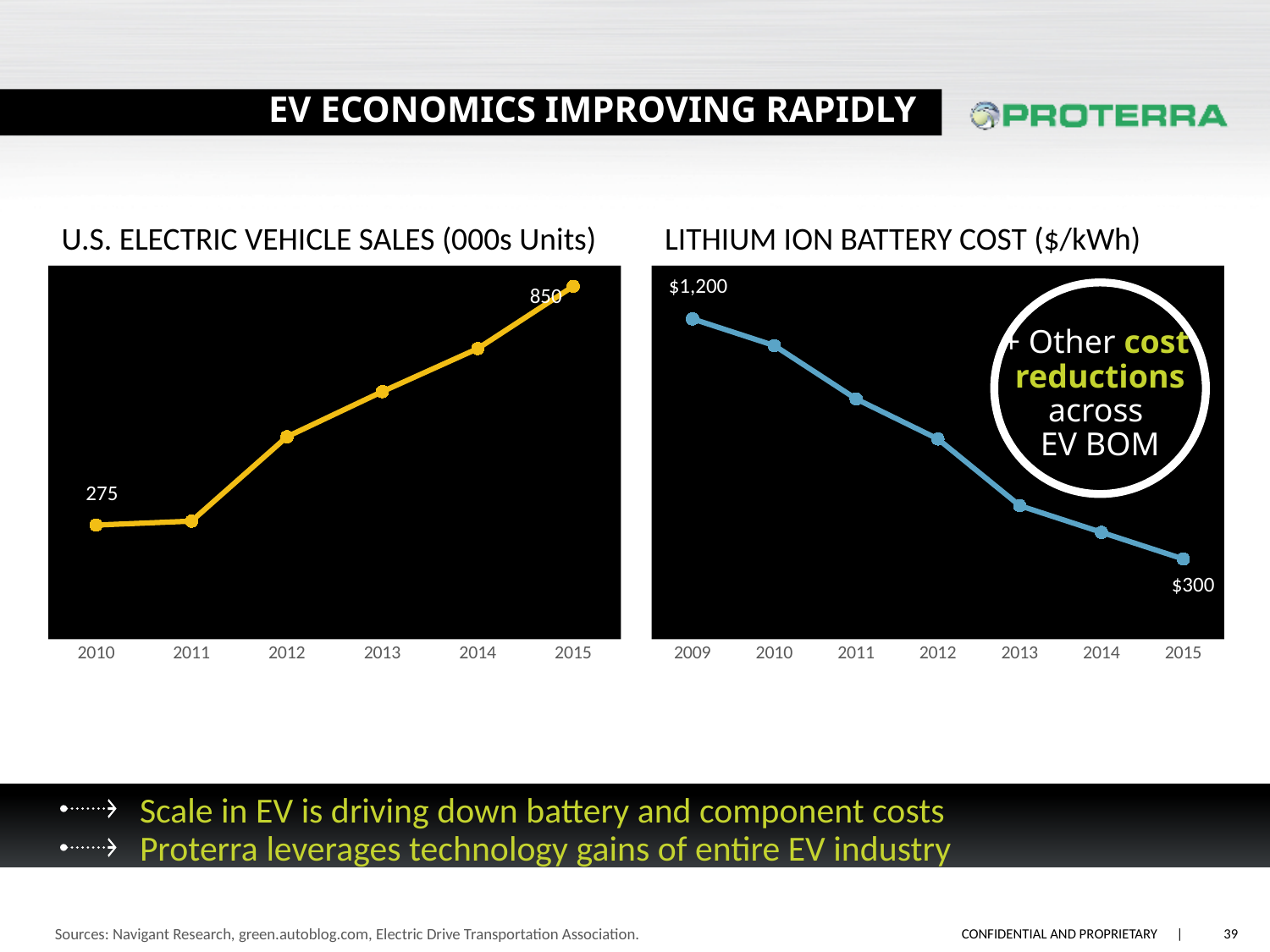
What kind of chart is the U.S. Electric Vehicle Sales chart? line chart In the Lithium Ion Battery Cost chart, which year has the lowest value? 2015 How many years are plotted in the Lithium Ion Battery Cost chart? 7 In the Lithium Ion Battery Cost chart, what is the value for 2009? $1,200 In the Lithium Ion Battery Cost chart, what is the difference between the 2009 and 2015 values? $900 In the U.S. Electric Vehicle Sales chart, what is the value for 2015? 850 In the Lithium Ion Battery Cost chart, what is the value for 2015? $300 In the Lithium Ion Battery Cost chart, is the value for 2011 larger or smaller than the value for 2013? larger In the U.S. Electric Vehicle Sales chart, what is the difference between the 2015 and 2010 values? 575 In the U.S. Electric Vehicle Sales chart, which year has the highest value? 2015 In the U.S. Electric Vehicle Sales chart, what is the value for 2010? 275 In the Lithium Ion Battery Cost chart, do the values rise or fall from 2009 to 2015? fall